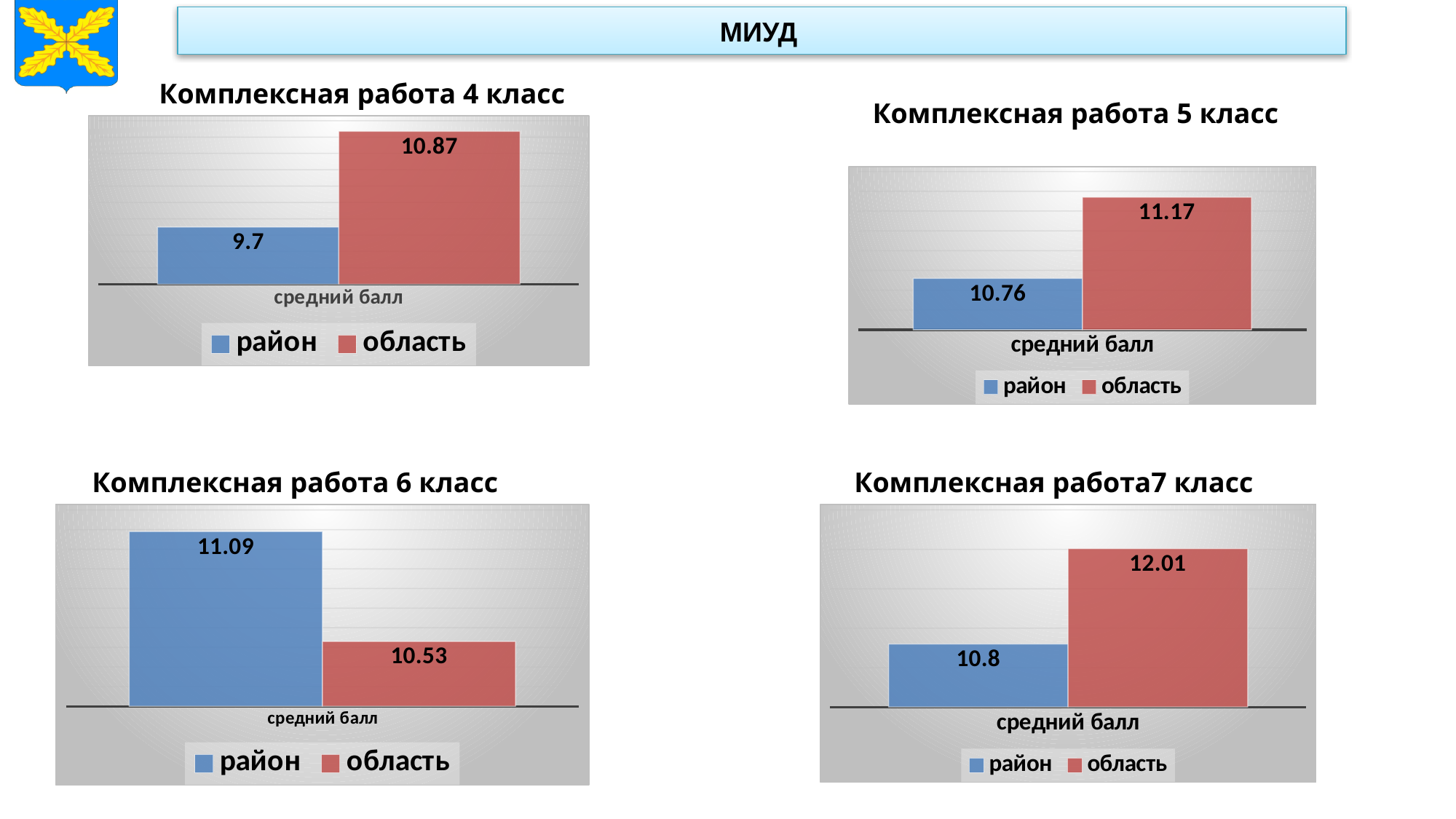
In the chart 'Комплексная работа7 класс', what is the value for область? 12.01 What is the x-axis category label in the chart 'Комплексная работа7 класс'? средний балл How many series does the legend of the chart 'Комплексная работа 5 класс' list? 2 In the chart 'Комплексная работа 6 класс', which series has the higher value, район or область? район In the chart 'Комплексная работа 4 класс', which series has the lowest value? район In the chart 'Комплексная работа 4 класс', what is the value for район? 9.7 In the chart 'Комплексная работа 5 класс', what is the difference between область and район? 0.41 In the chart 'Комплексная работа7 класс', what is the difference between область and район? 1.21 In the chart 'Комплексная работа 4 класс', what is the value for область? 10.87 In the chart 'Комплексная работа 6 класс', what is the value for область? 10.53 In the chart 'Комплексная работа 5 класс', what is the value for район? 10.76 What kind of chart is 'Комплексная работа 6 класс'? bar chart